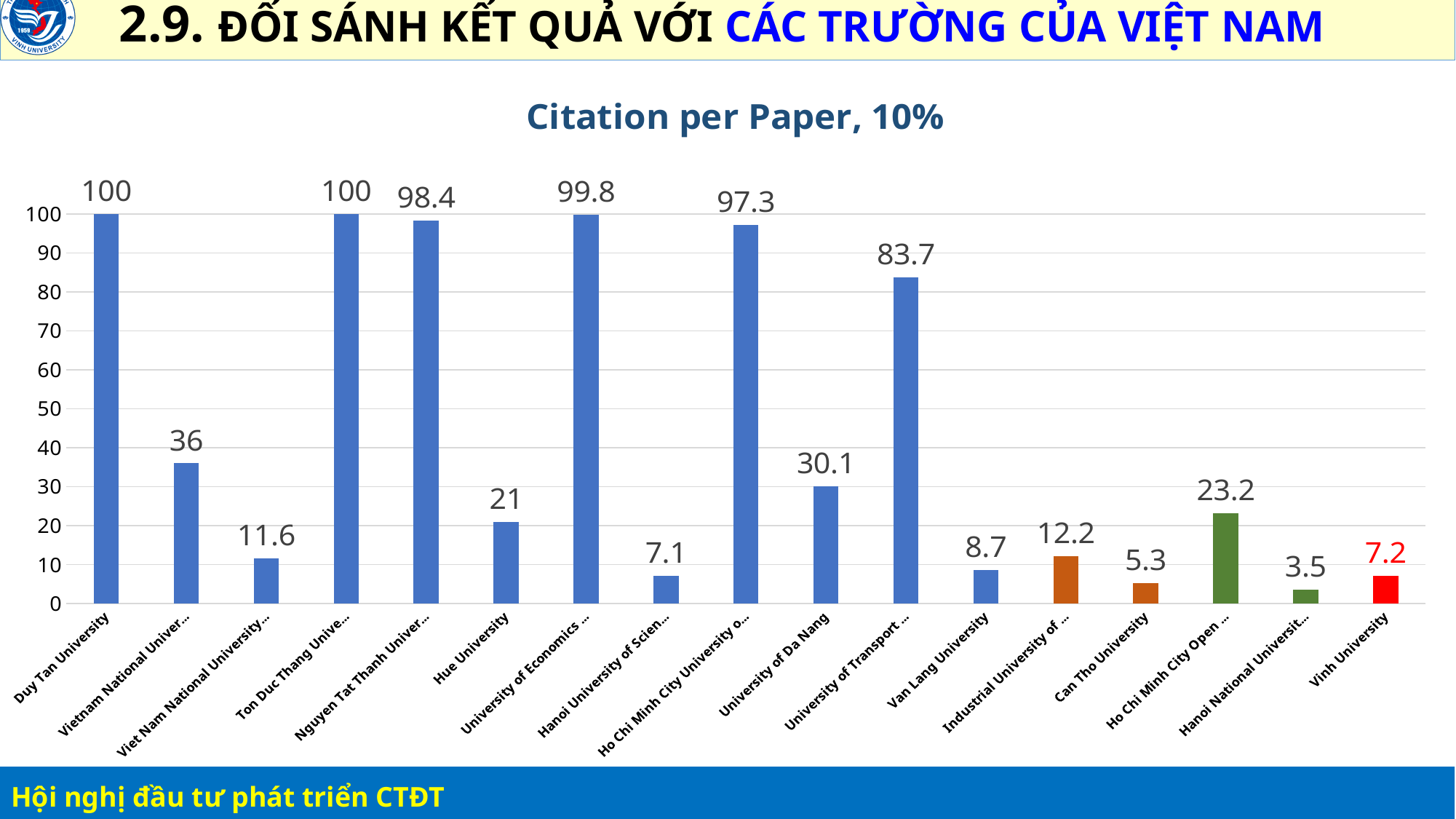
What is the value for Duy Tan University? 100 What kind of chart is shown on the slide? Bar chart What is the value for Vinh University? 7.2 What is the lowest value shown in the chart? 3.5 How many universities are shown in the chart? 17 Which has a larger value, Van Lang University or Vinh University? Van Lang University What is the value for University of Da Nang? 30.1 Is the value for Duy Tan University greater or less than 90? greater What is the value for Can Tho University? 5.3 What is the difference between the values for University of Da Nang and Hue University? 9.1 What is the title of the chart? Citation per Paper, 10% What is the value for Hue University? 21